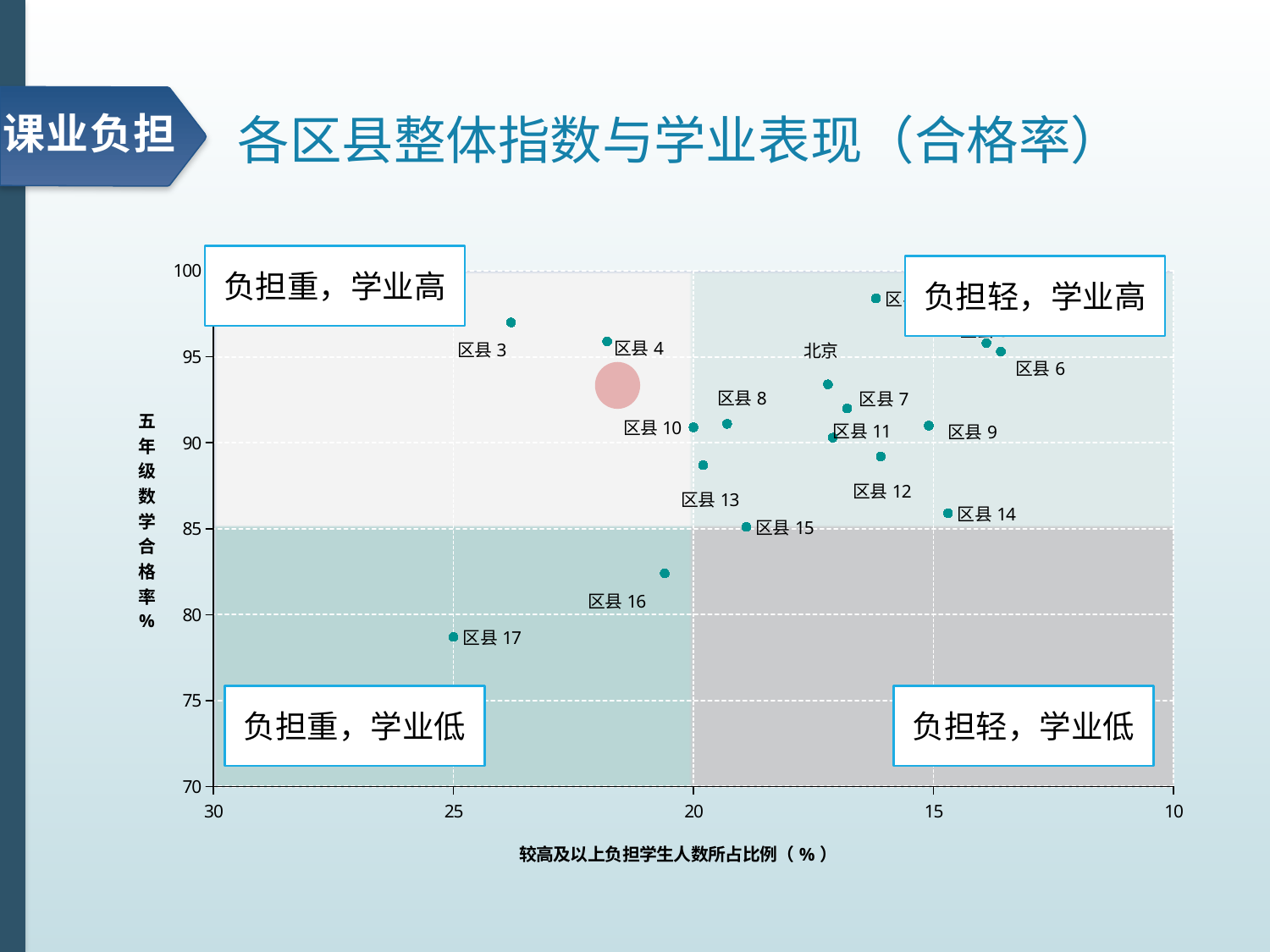
Is the value for 区县 17 on the vertical axis (五年级数学合格率) greater or less than 80? less Which has a higher 五年级数学合格率, 区县 3 or 区县 17? 区县 3 Is the value for 区县 16 on the vertical axis greater or less than 85? less What kind of chart is shown on the slide? scatter chart Is the value for 区县 3 on the horizontal axis (较高及以上负担学生人数所占比例) greater or less than 20? greater Which has a higher 五年级数学合格率, 区县 14 or 区县 16? 区县 14 Which labeled district has the lowest 五年级数学合格率? 区县 17 What is the title of the chart? 各区县整体指数与学业表现（合格率）